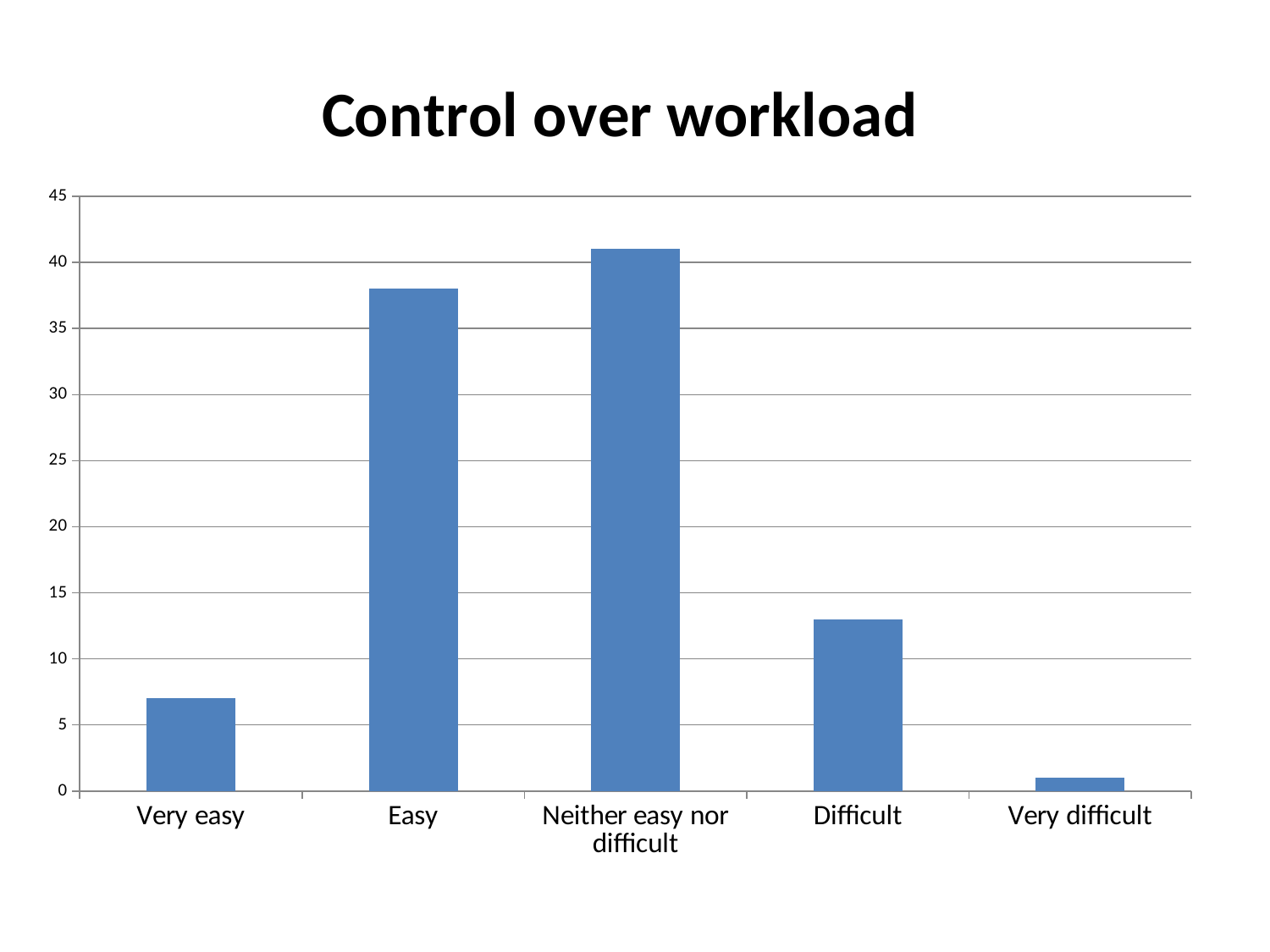
Which is larger, the value for Easy or the value for Difficult? Easy Which category has the highest value? Neither easy nor difficult Is the value for Difficult greater or less than 10? greater Which is larger, the value for Very easy or the value for Difficult? Difficult What kind of chart is shown on the slide? bar chart How many categories are shown on the x axis? 5 Is the value for Easy greater or less than 35? greater Which category has the lowest value? Very difficult Is the value for Very easy greater or less than 10? less What is the title of the chart? Control over workload